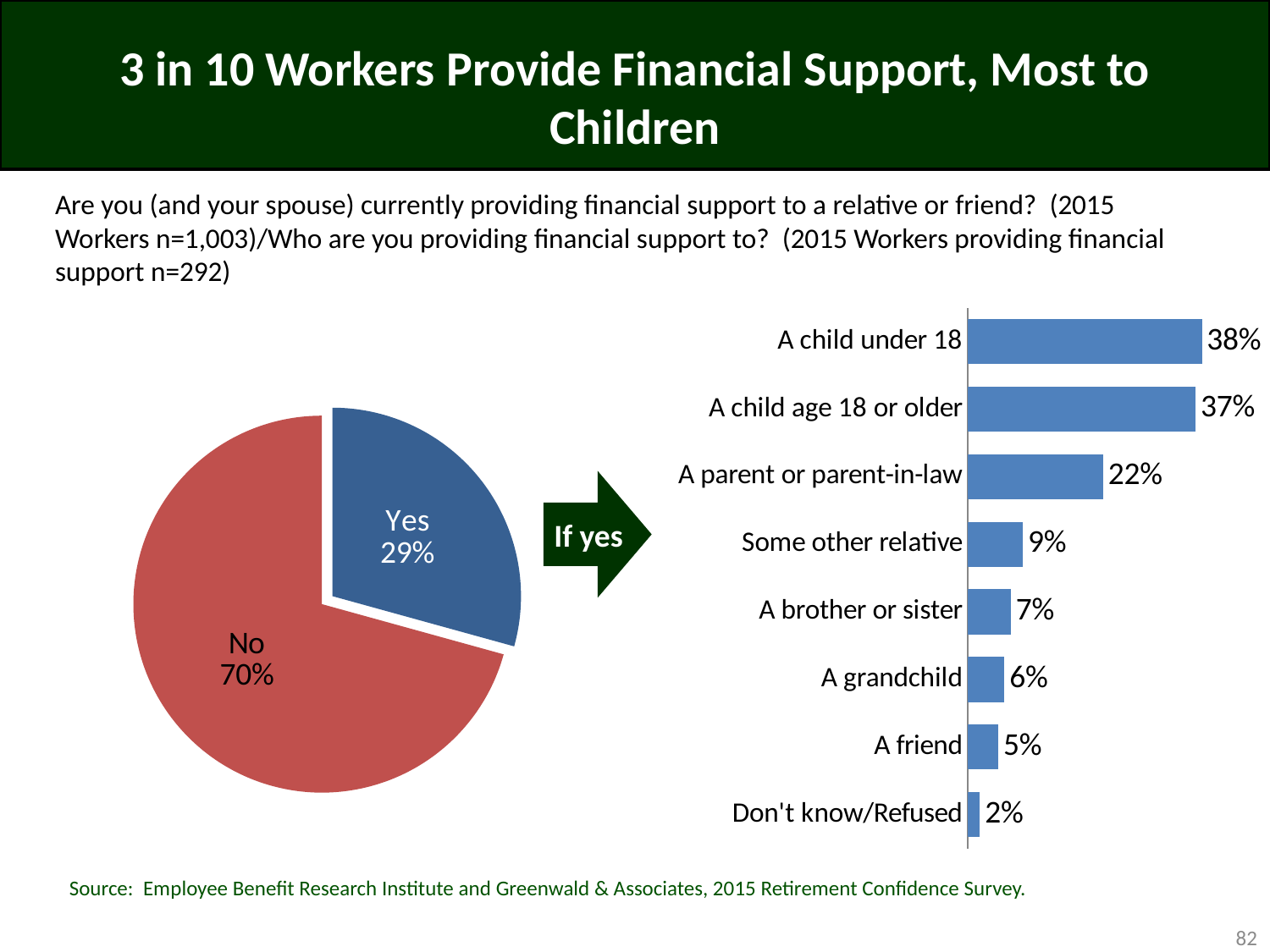
In the bar chart on the right, which category has the highest value? A child under 18 In the bar chart on the right, which category has the lowest value? Don't know/Refused In the bar chart on the right, how many categories are shown? 8 In the pie chart on the left, what percentage of workers answered No? 70% In the pie chart on the left, what percentage of workers answered Yes? 29% What kind of chart is on the right side of the slide? Bar chart In the bar chart on the right, what is the difference between A child under 18 and A parent or parent-in-law? 16% What kind of chart is on the left side of the slide? Pie chart In the pie chart on the left, which slice is larger, Yes or No? No In the bar chart on the right, what is the value for A grandchild? 6% In the bar chart on the right, which is larger, Some other relative or A friend? Some other relative In the bar chart on the right, what is the value for A parent or parent-in-law? 22%